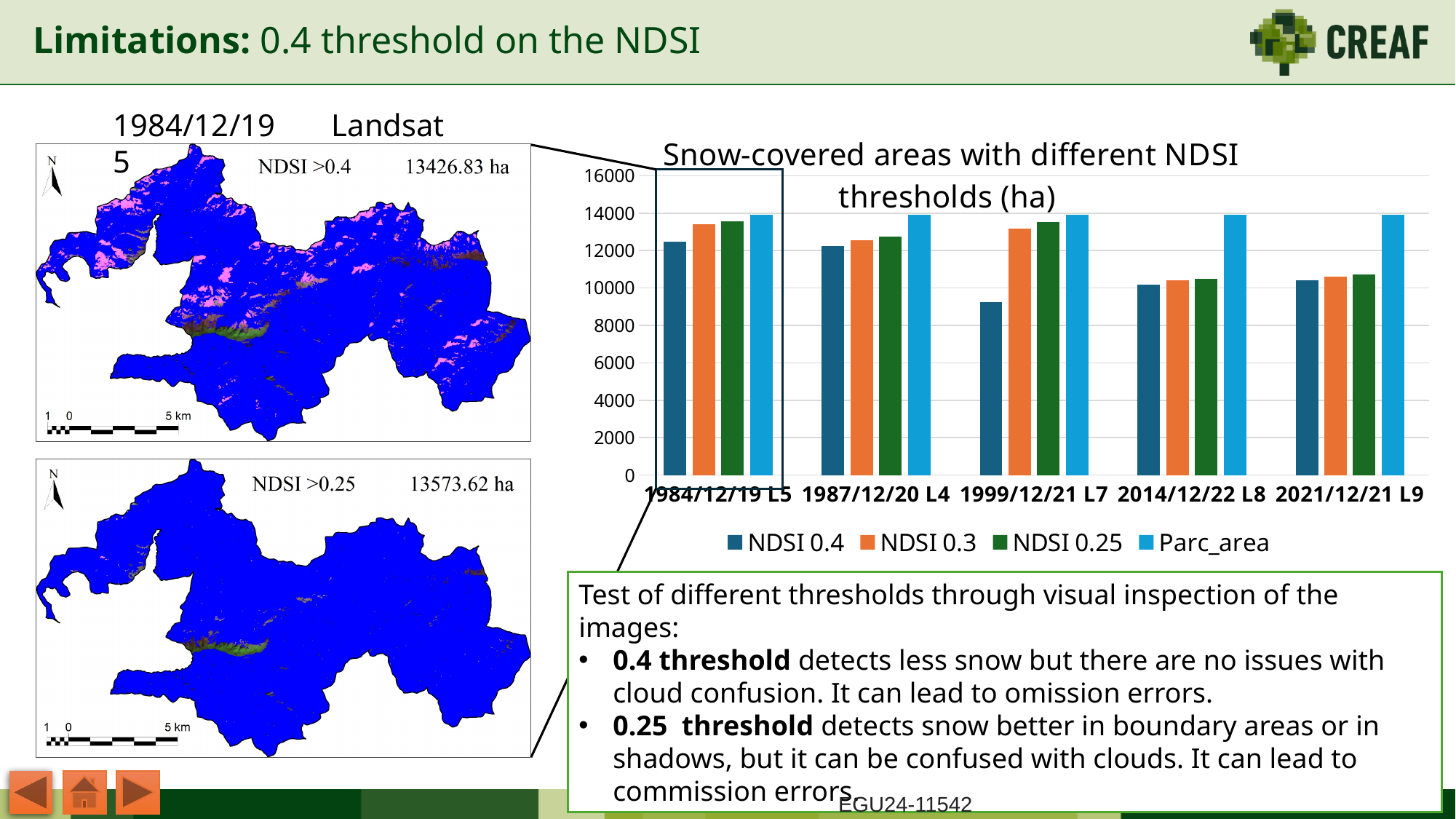
What kind of chart is shown on the slide? bar chart What is the title of the chart? Snow-covered areas with different NDSI thresholds (ha) Is the NDSI 0.25 value for 2021/12/21 L9 greater or less than 10000? greater Which date category has the lowest NDSI 0.4 value in the chart? 1999/12/21 L7 Is the NDSI 0.4 value for 1999/12/21 L7 greater or less than 10000? less Is the NDSI 0.3 value for 1999/12/21 L7 greater or less than 12000? greater Which series is shown in light blue in the chart legend? Parc_area How many date categories are shown on the x axis of the chart? 5 How many series does the chart legend list? 4 Within the 1984/12/19 L5 group, do the bars rise or fall going from NDSI 0.4 to Parc_area? rise Which is larger, the NDSI 0.4 value for 1984/12/19 L5 or for 2014/12/22 L8? 1984/12/19 L5